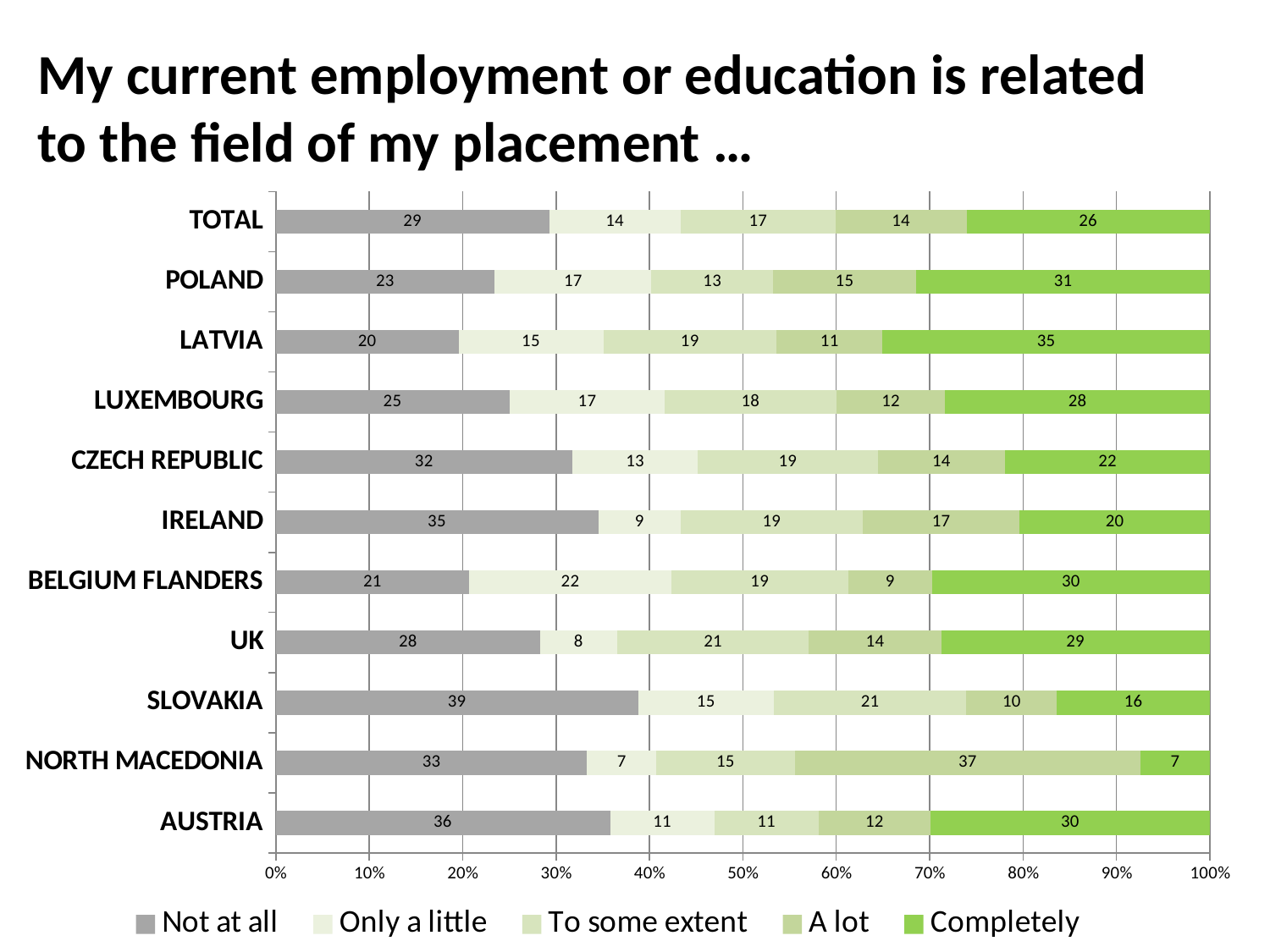
What is the value for "Not at all" for SLOVAKIA? 39 What is the value for "Completely" for LATVIA? 35 How many series does the legend list? 5 Which category has the highest value for "Not at all"? SLOVAKIA How many categories are shown on the chart? 11 What is the difference between the "Completely" values for POLAND and IRELAND? 11 What is the value for "A lot" for NORTH MACEDONIA? 37 What kind of chart is this? Stacked bar chart What is the value for "Only a little" for UK? 8 Which legend entry is shown in grey? Not at all Which category has the lowest value for "Completely"? NORTH MACEDONIA Which is larger, the "Not at all" value for AUSTRIA or for CZECH REPUBLIC? AUSTRIA